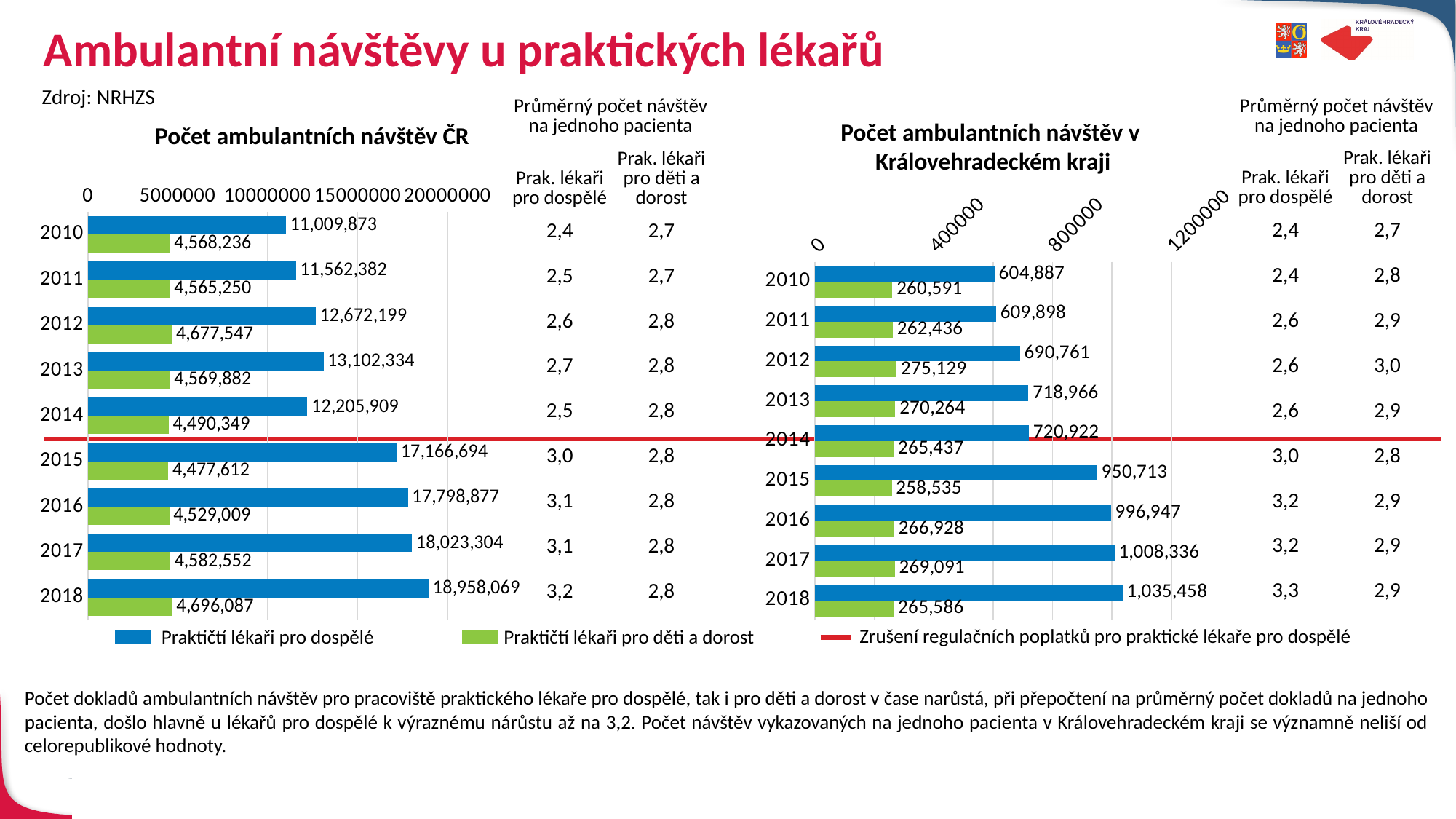
In the chart 'Počet ambulantních návštěv ČR', what is the value for Praktičtí lékaři pro děti a dorost in 2014? 4,490,349 In the chart 'Počet ambulantních návštěv v Královehradeckém kraji', what is the value for Praktičtí lékaři pro děti a dorost in 2012? 275,129 What kind of chart is 'Počet ambulantních návštěv v Královehradeckém kraji'? Bar chart In the chart 'Počet ambulantních návštěv ČR', what is the difference between the Praktičtí lékaři pro dospělé values for 2018 and 2017? 934,765 In the chart 'Počet ambulantních návštěv ČR', which year has the lowest value for Praktičtí lékaři pro dospělé? 2010 In the chart 'Počet ambulantních návštěv v Královehradeckém kraji', what is the value for Praktičtí lékaři pro dospělé in 2015? 950,713 In the chart 'Počet ambulantních návštěv ČR', what is the value for Praktičtí lékaři pro dospělé in 2018? 18,958,069 How many years are shown on the x axis of the chart 'Počet ambulantních návštěv ČR'? 9 In the chart 'Počet ambulantních návštěv v Královehradeckém kraji', which year has the lowest value for Praktičtí lékaři pro děti a dorost? 2015 In the chart 'Počet ambulantních návštěv ČR', which year has the highest value for Praktičtí lékaři pro dospělé? 2018 In the chart 'Počet ambulantních návštěv v Královehradeckém kraji', which is larger: the Praktičtí lékaři pro dospělé value for 2014 or for 2015? 2015